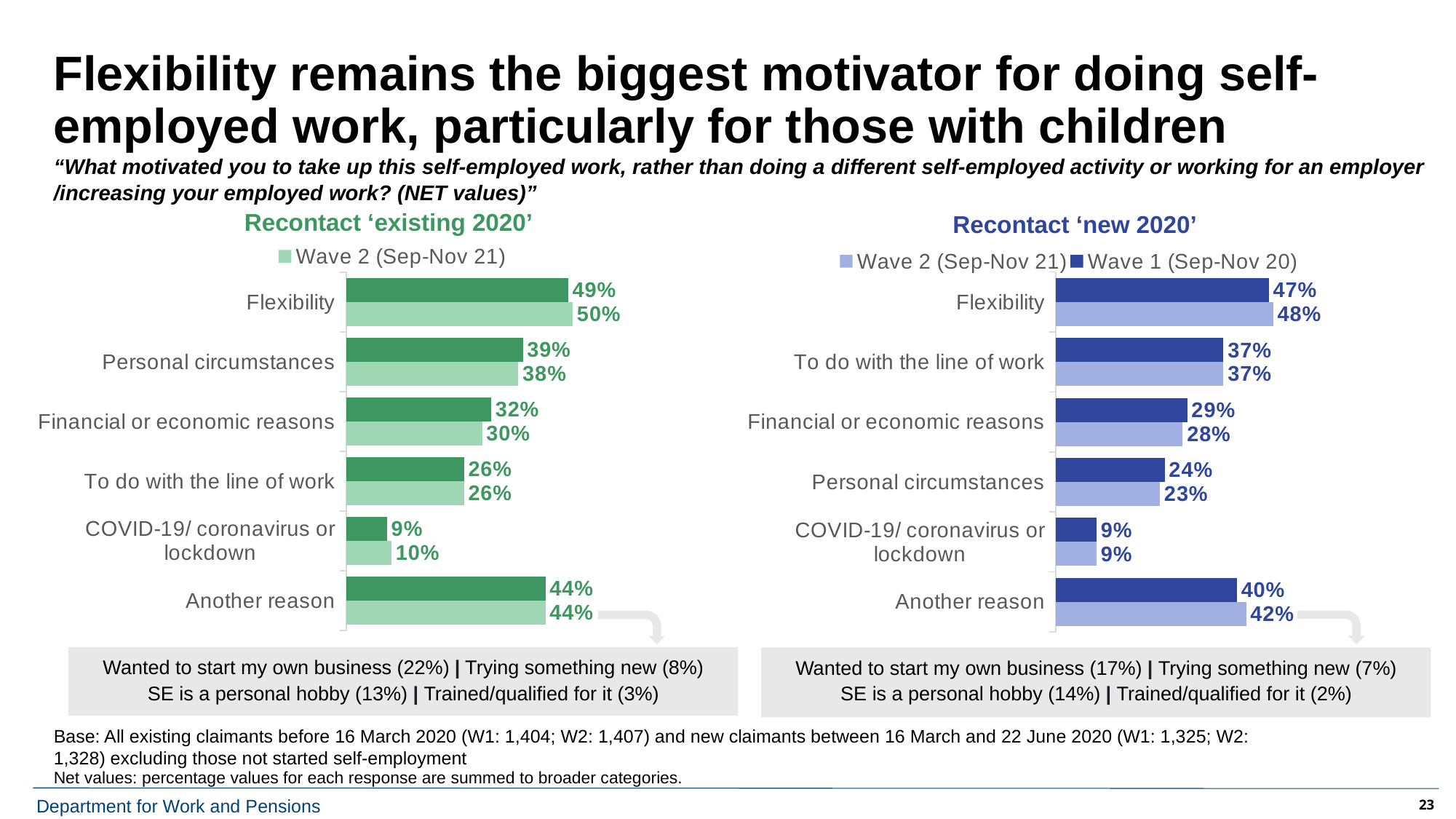
In the 'Recontact ‘new 2020’' chart, what is the Wave 2 (Sep-Nov 21) value for Another reason? 42% In the 'Recontact ‘existing 2020’' chart, what is the Wave 2 (Sep-Nov 21) value for Flexibility? 50% How many categories are shown in the 'Recontact ‘existing 2020’' chart? 6 In the 'Recontact ‘new 2020’' chart, which has the larger Wave 2 (Sep-Nov 21) value: Financial or economic reasons or Personal circumstances? Financial or economic reasons In the 'Recontact ‘existing 2020’' chart, which category has the lowest Wave 2 (Sep-Nov 21) value? COVID-19/ coronavirus or lockdown In the 'Recontact ‘existing 2020’' chart, what is the Wave 2 (Sep-Nov 21) value for Personal circumstances? 38% In the 'Recontact ‘new 2020’' chart, what is the Wave 1 (Sep-Nov 20) value for Flexibility? 47% In the 'Recontact ‘new 2020’' chart, which category has the highest Wave 2 (Sep-Nov 21) value? Flexibility What type of chart is the 'Recontact ‘new 2020’' chart? Bar chart How many series does the legend of the 'Recontact ‘new 2020’' chart list? 2 In the 'Recontact ‘new 2020’' chart, what is the Wave 1 (Sep-Nov 20) value for COVID-19/ coronavirus or lockdown? 9% In the 'Recontact ‘new 2020’' chart, what is the difference between the Wave 1 (Sep-Nov 20) values for Flexibility and To do with the line of work? 10 percentage points